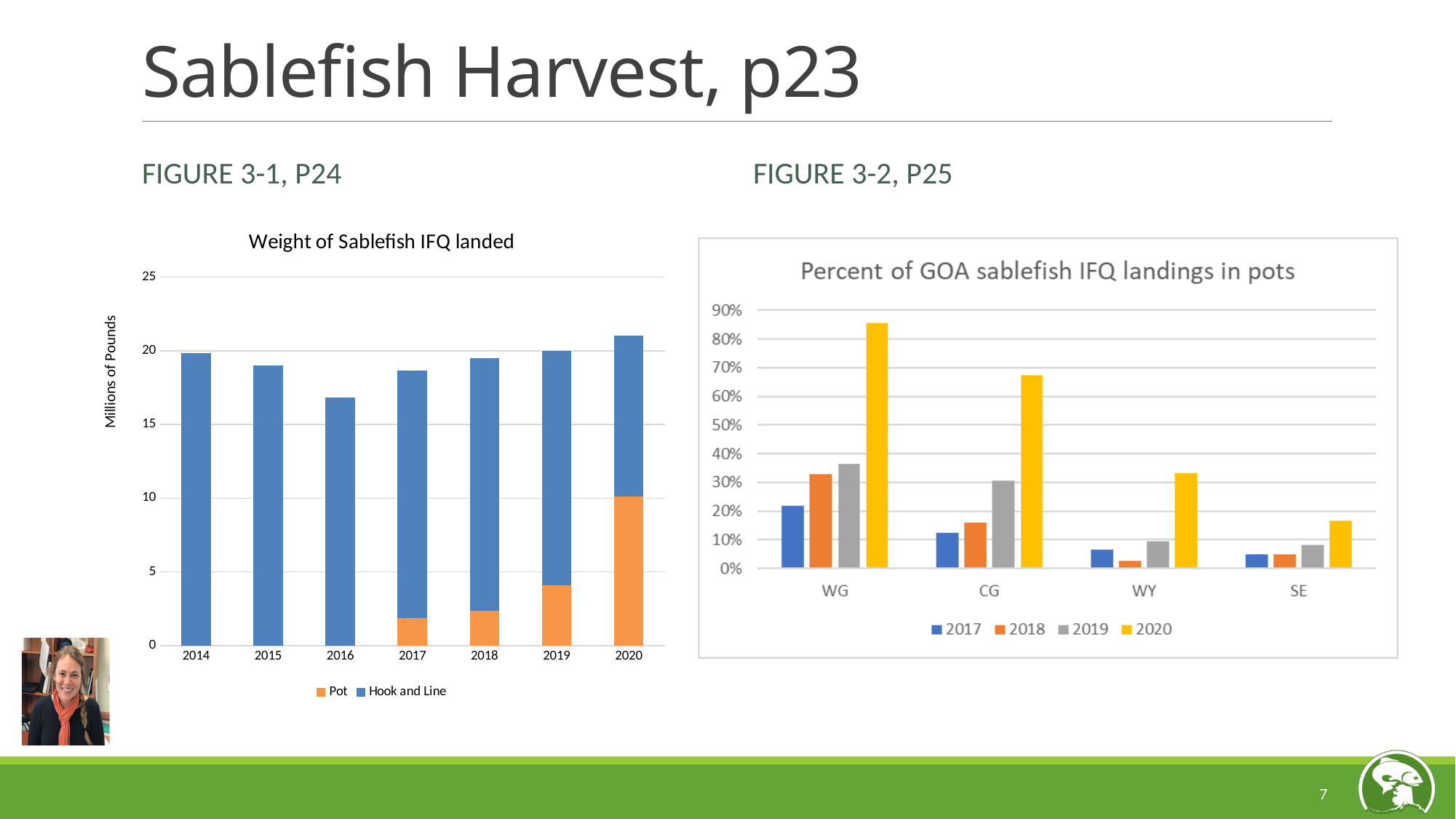
In the 'Weight of Sablefish IFQ landed' chart, which year has the highest total bar? 2020 In the 'Weight of Sablefish IFQ landed' chart, is the Pot value for 2019 greater or less than 5 million pounds? less In the 'Weight of Sablefish IFQ landed' chart, what is the y-axis label? Millions of Pounds In the 'Weight of Sablefish IFQ landed' chart, which year has the lowest total bar? 2016 In the 'Weight of Sablefish IFQ landed' chart, is the total for 2016 greater or less than 20 million pounds? less In the 'Percent of GOA sablefish IFQ landings in pots' chart, how many series does the legend list? 4 What kind of chart is the 'Weight of Sablefish IFQ landed' chart? bar chart In the 'Weight of Sablefish IFQ landed' chart, how many years are shown on the x axis? 7 In the 'Weight of Sablefish IFQ landed' chart, how many series does the legend list? 2 In the 'Percent of GOA sablefish IFQ landings in pots' chart, do the WG values rise or fall from 2017 to 2020? rise In the 'Percent of GOA sablefish IFQ landings in pots' chart, which area has the highest 2020 value? WG In the 'Percent of GOA sablefish IFQ landings in pots' chart, is the 2020 value for WG greater or less than 80%? greater